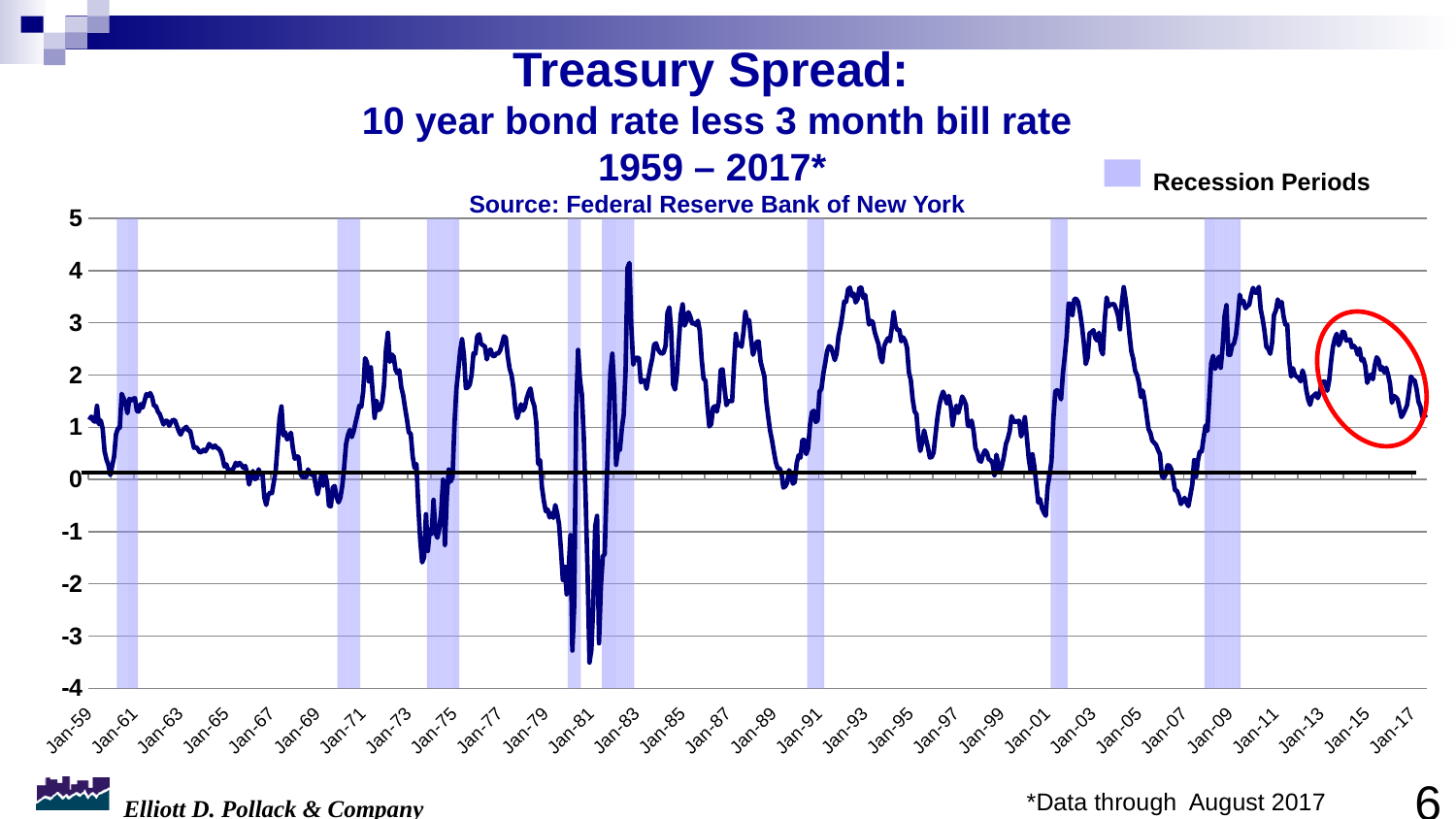
Is the lowest point of the line, around 1980–1981, greater or less than -3? less Is the value at Jan-65 greater or less than 2? less What is the last date label on the x axis? Jan-17 Is the value at the end of the series in 2017 greater or less than 0? greater What is the highest value shown on the y axis? 5 How many shaded recession periods are marked on the chart? 8 What do the shaded vertical bands on the chart represent, according to the legend? Recession Periods What is the first date label on the x axis? Jan-59 What is the title of the chart? Treasury Spread: 10 year bond rate less 3 month bill rate 1959 – 2017* What kind of chart is shown on the slide? line chart What is the lowest value shown on the y axis? -4